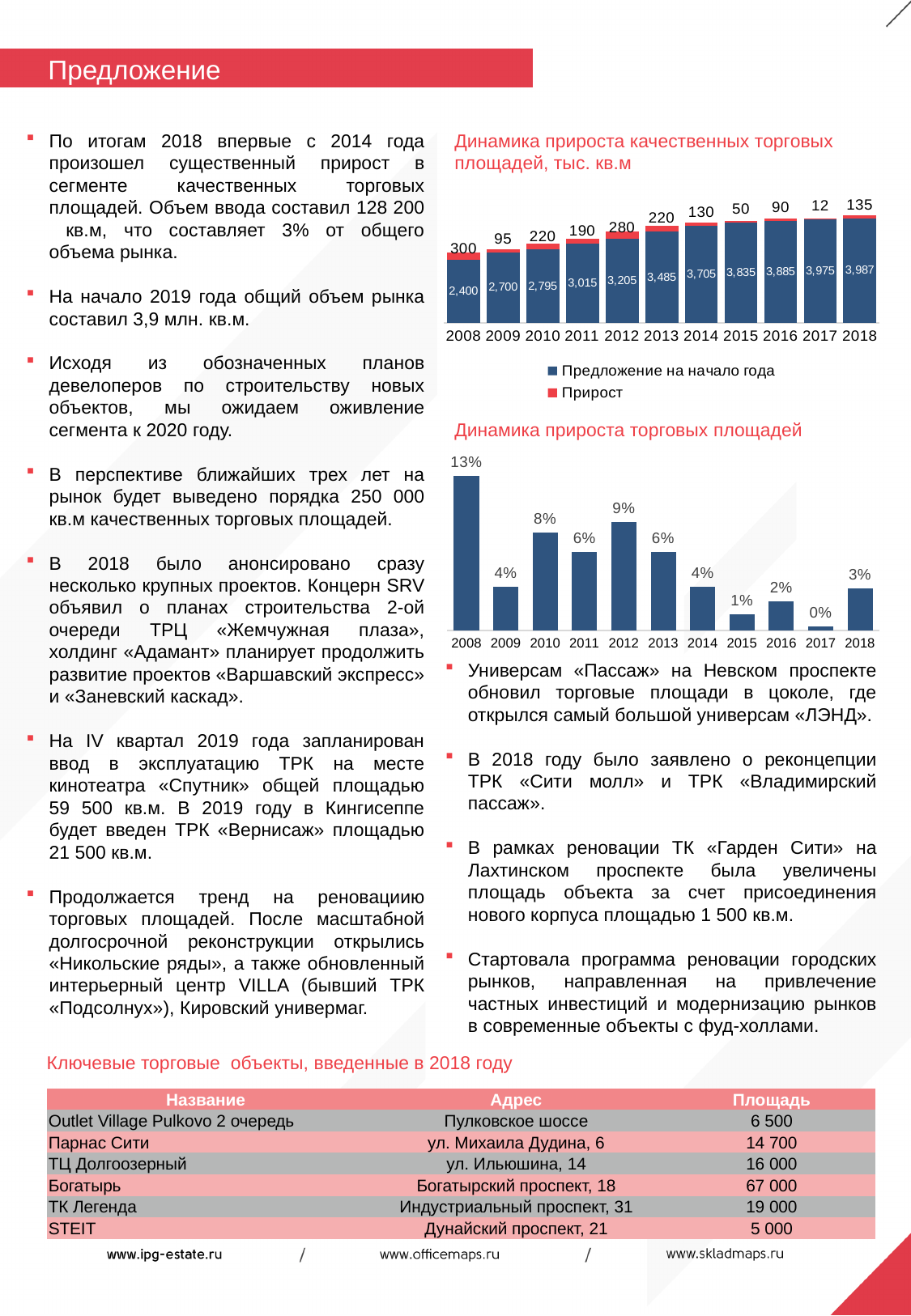
In the chart 'Динамика прироста торговых площадей', which year has the lowest value? 2017 In the chart 'Динамика прироста качественных торговых площадей, тыс. кв.м', which year has the highest 'Прирост' value? 2008 In the chart 'Динамика прироста качественных торговых площадей, тыс. кв.м', what is the total of the stacked bar for 2008? 2,700 In the chart 'Динамика прироста качественных торговых площадей, тыс. кв.м', what is the value of 'Прирост' for 2012? 280 In the chart 'Динамика прироста торговых площадей', which is larger, the value for 2010 or the value for 2012? 2012 In the chart 'Динамика прироста качественных торговых площадей, тыс. кв.м', how many series does the legend list? 2 What kind of chart is 'Динамика прироста торговых площадей'? bar chart In the chart 'Динамика прироста торговых площадей', how many years are shown on the x axis? 11 In the chart 'Динамика прироста качественных торговых площадей, тыс. кв.м', which year has the lowest 'Прирост' value? 2017 In the chart 'Динамика прироста качественных торговых площадей, тыс. кв.м', what is the value of 'Предложение на начало года' for 2018? 3,987 In the chart 'Динамика прироста торговых площадей', what is the value for 2008? 13% In the chart 'Динамика прироста качественных торговых площадей, тыс. кв.м', what is the difference between 'Предложение на начало года' in 2018 and in 2008? 1,587